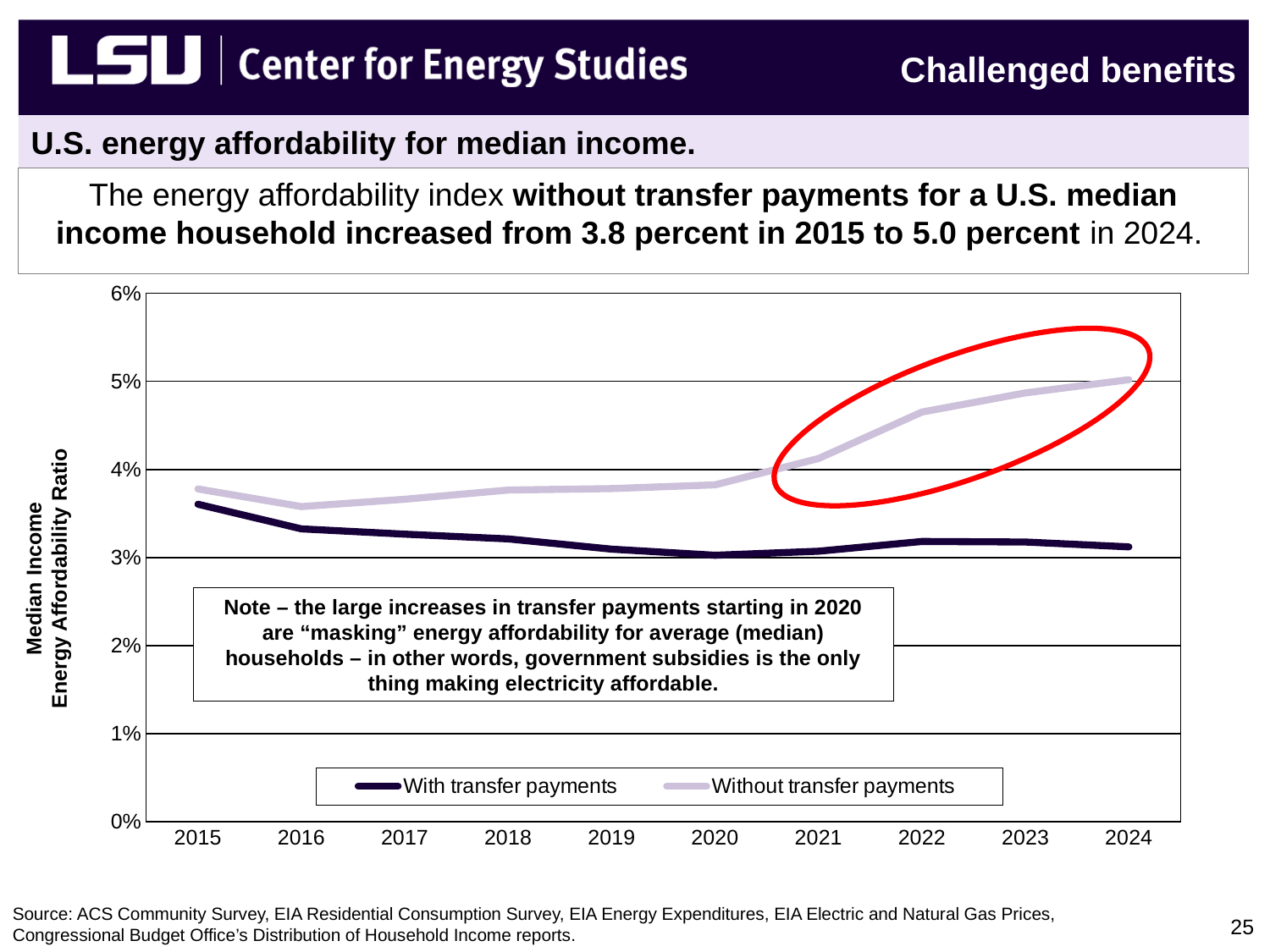
What is the label on the chart's y axis? Median Income Energy Affordability Ratio How many years are shown along the x axis of the chart? 10 In 2024, which series has the higher value: 'With transfer payments' or 'Without transfer payments'? Without transfer payments In which year does the 'Without transfer payments' series reach its highest value? 2024 How many series does the chart's legend list? 2 Is the value for 'With transfer payments' in 2020 greater or less than 4%? less Does the 'Without transfer payments' line rise or fall from 2020 to 2024? rise Does the 'With transfer payments' line rise or fall from 2015 to 2020? fall Is the value for 'With transfer payments' in 2015 greater or less than 3%? greater Is the value for 'Without transfer payments' in 2024 greater or less than 4%? greater What kind of chart is shown on the slide? line chart What are the two entries in the chart's legend? With transfer payments; Without transfer payments